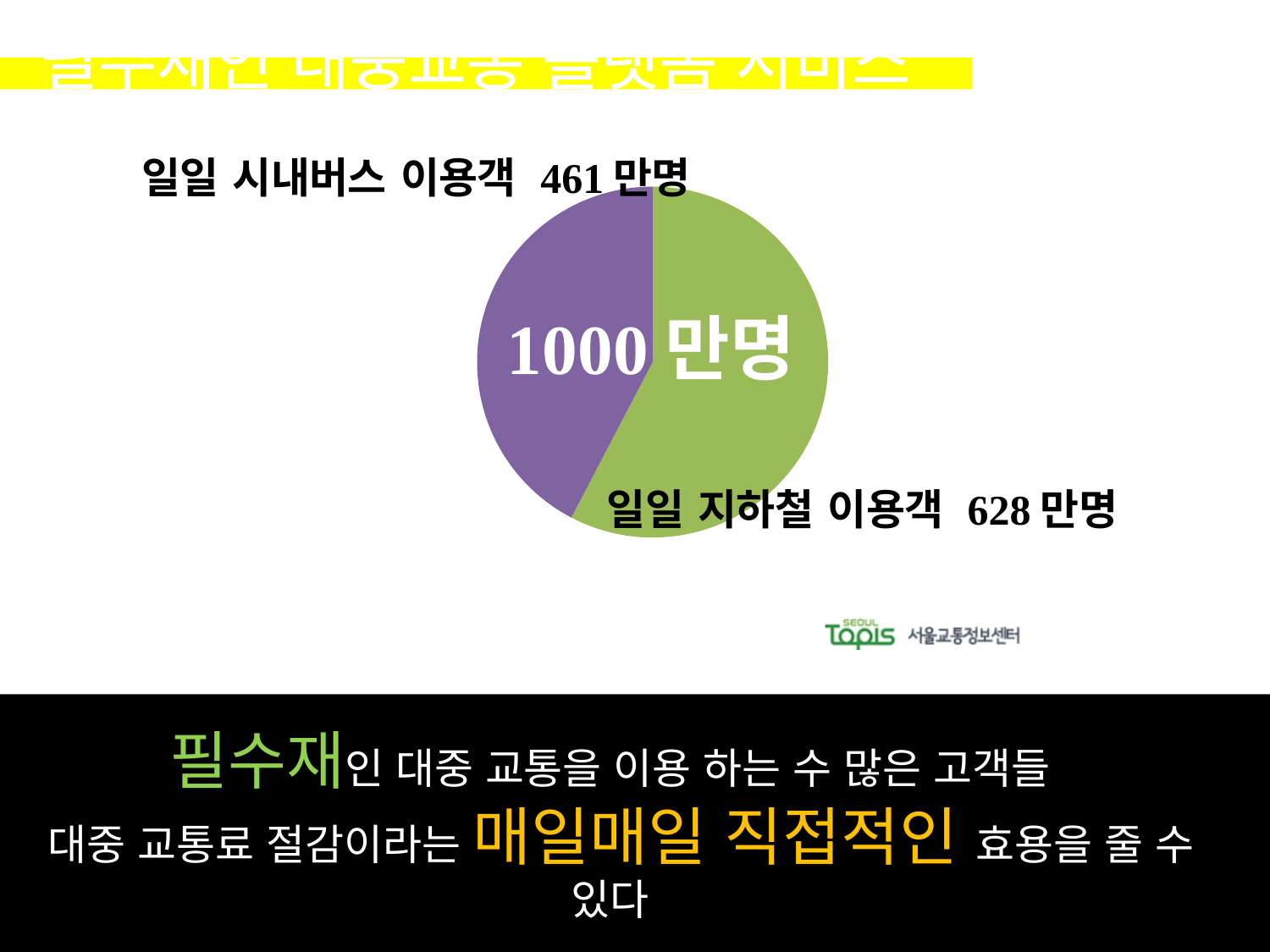
What text is printed in the centre of the pie chart? 1000 만명 Is the value for 일일 시내버스 이용객 larger or smaller than the value for 일일 지하철 이용객? smaller What kind of chart is shown on the slide? pie chart What colour is the slice for 일일 지하철 이용객? green How many slices does the pie chart have? 2 What is the value shown for 일일 지하철 이용객 in the pie chart? 628 만명 Which category has the larger value in the pie chart? 일일 지하철 이용객 What is the value shown for 일일 시내버스 이용객 in the pie chart? 461 만명 Which category has the smaller value in the pie chart? 일일 시내버스 이용객 What is the difference between the 일일 지하철 이용객 value and the 일일 시내버스 이용객 value? 167 만명